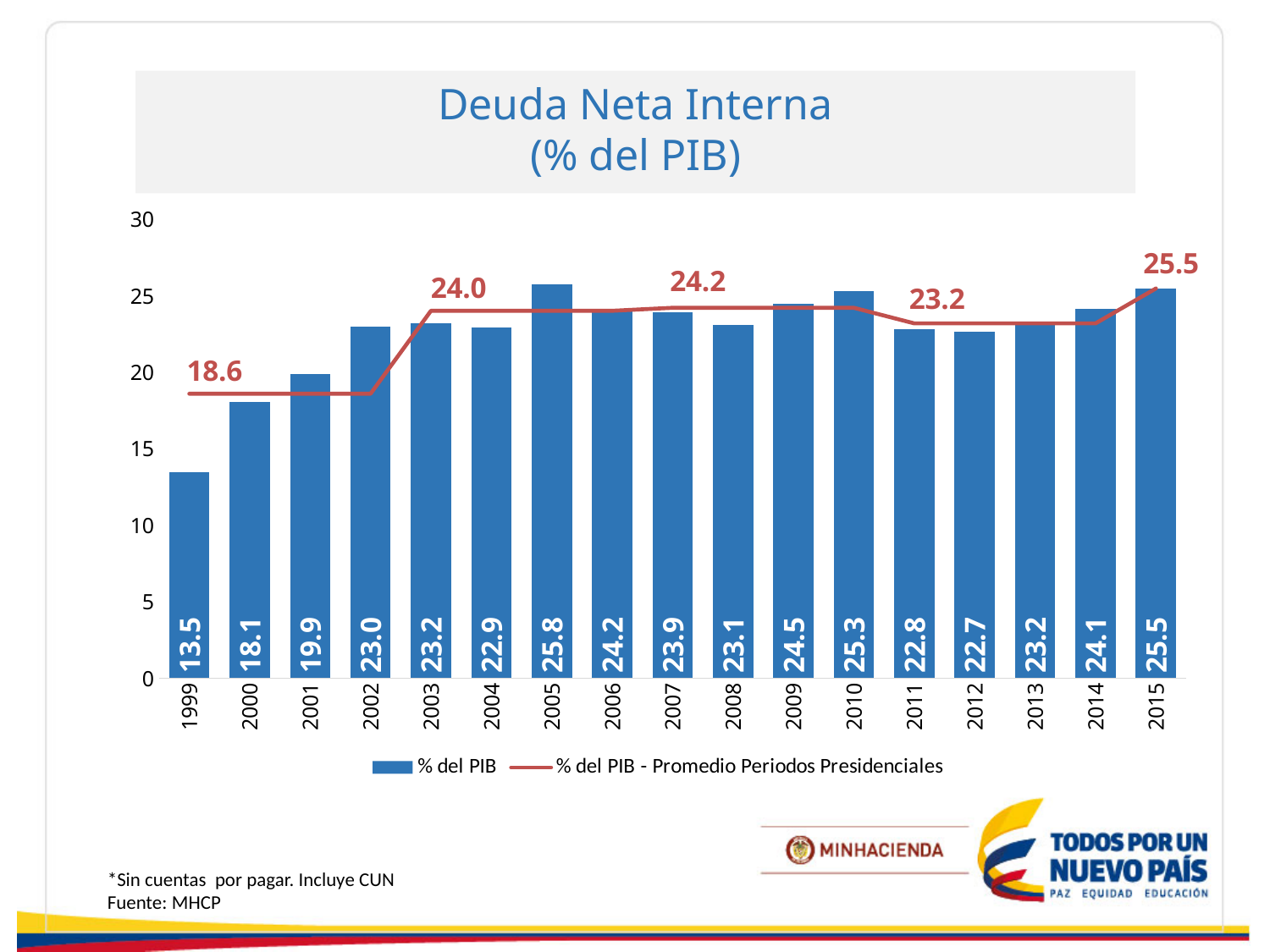
What kind of chart is used for the % del PIB series? Bar chart Which year has the highest % del PIB bar? 2005 What is the value of the % del PIB bar for 2005? 25.8 What is the difference between the % del PIB bars for 2015 and 1999? 12.0 What is the first value labelled on the red 'Promedio Periodos Presidenciales' line? 18.6 What is the value of the % del PIB bar for 2012? 22.7 Which year has the lowest % del PIB bar? 1999 What is the title of the chart? Deuda Neta Interna (% del PIB) How many series does the legend list? 2 What is the value of the % del PIB bar for 1999? 13.5 How many years are shown on the x axis? 17 Which is larger, the % del PIB bar for 2010 or for 2011? 2010